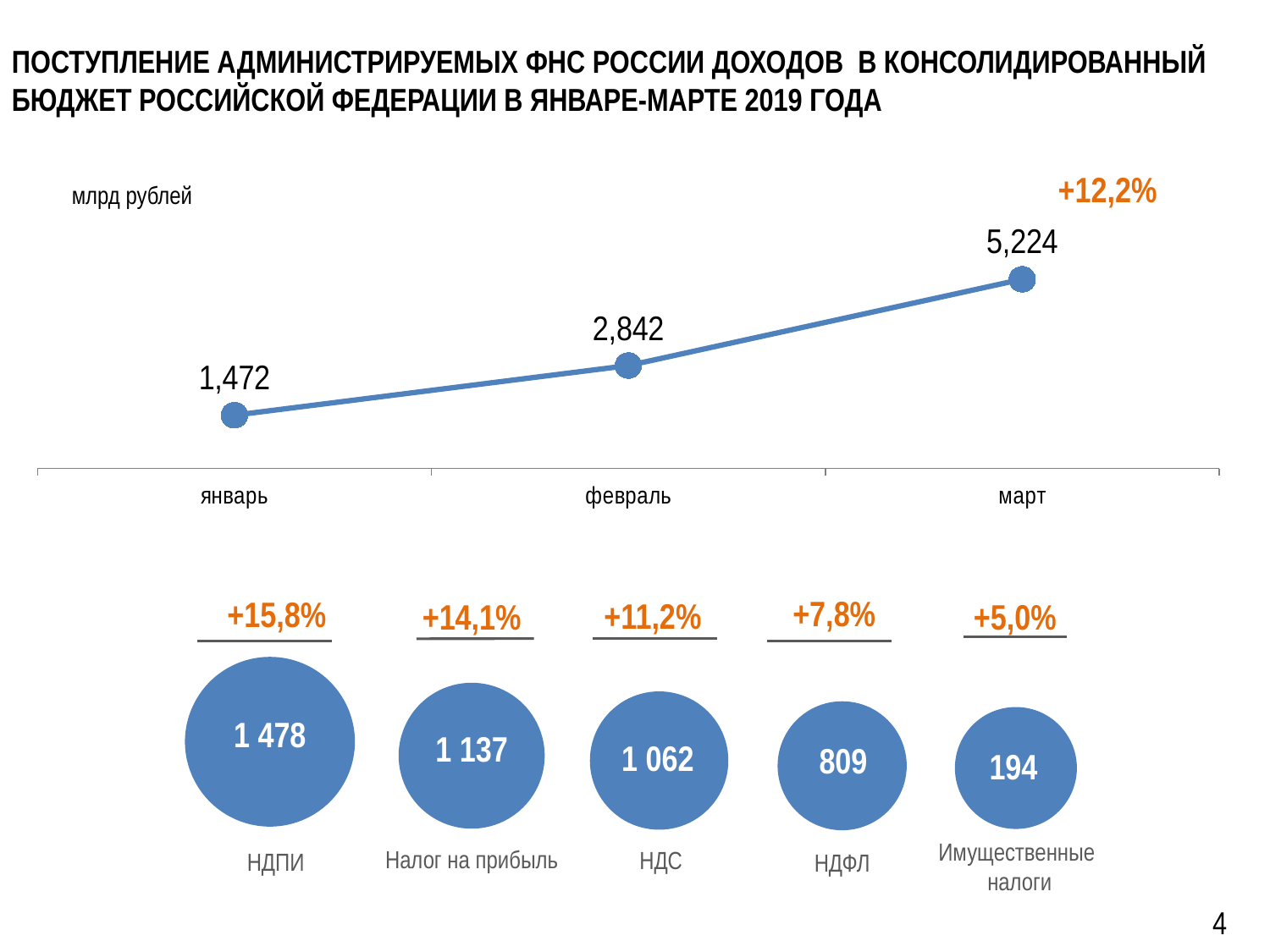
On the bottom chart, what is the difference between the values for НДПИ and Налог на прибыль? 341 On the bottom chart, what is the value for НДС? 1 062 On the bottom chart, which category has the lowest value? Имущественные налоги On the top line chart, do the values rise or fall from январь to март? rise On the bottom chart, what growth percentage is shown above НДФЛ? +7,8% On the bottom chart, which category has the highest value? НДПИ What type of chart is shown at the top of the slide? line chart On the top line chart, what is the value for март? 5,224 On the top line chart, what is the difference between the values for февраль and январь? 1,370 On the top line chart, how many data points are plotted? 3 On the top line chart, what is the value for февраль? 2,842 On the top line chart, which month has the lowest value? январь